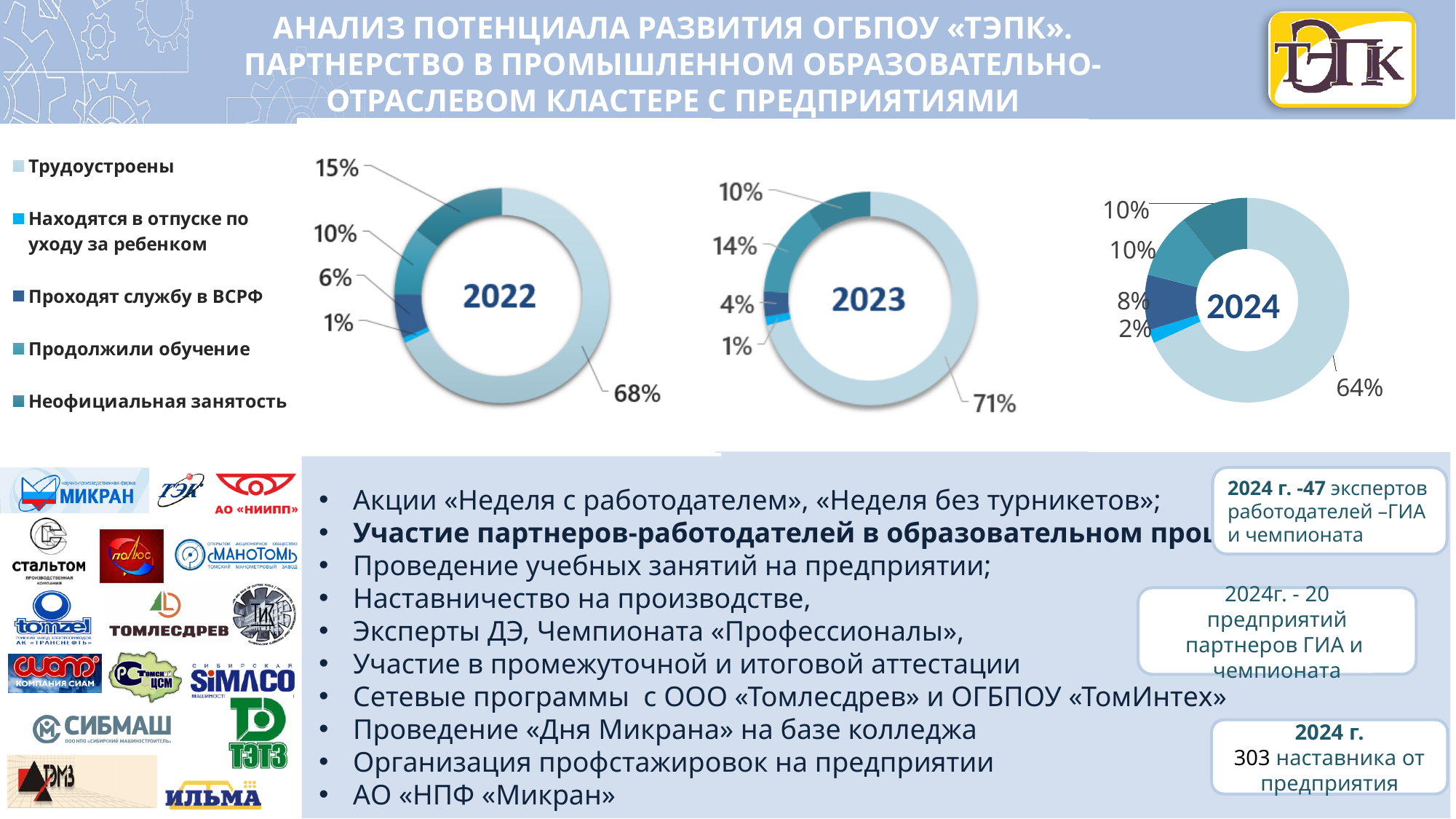
Which of the three donut charts (2022, 2023, 2024) shows the highest share for «Трудоустроены»? 2023 What is the difference between the «Трудоустроены» share in 2023 and in 2024? 7% What type of chart is used to show the 2022, 2023 and 2024 data? Donut (pie) chart In the 2023 donut chart, what share is labelled for «Продолжили обучение»? 14% In the 2024 donut chart, what share is labelled for «Проходят службу в ВСРФ»? 8% In the 2024 donut chart, what share is labelled for «Трудоустроены»? 64% In the 2023 donut chart, which is larger: the share for «Продолжили обучение» or for «Неофициальная занятость»? Продолжили обучение How many categories does the legend list for the donut charts? 5 In the 2022 donut chart, what share is labelled for «Трудоустроены»? 68% In the 2022 donut chart, what share is labelled for «Неофициальная занятость»? 15% In the 2023 donut chart, what share is labelled for «Трудоустроены»? 71% In the 2022 donut chart, which category has the smallest share? Находятся в отпуске по уходу за ребенком